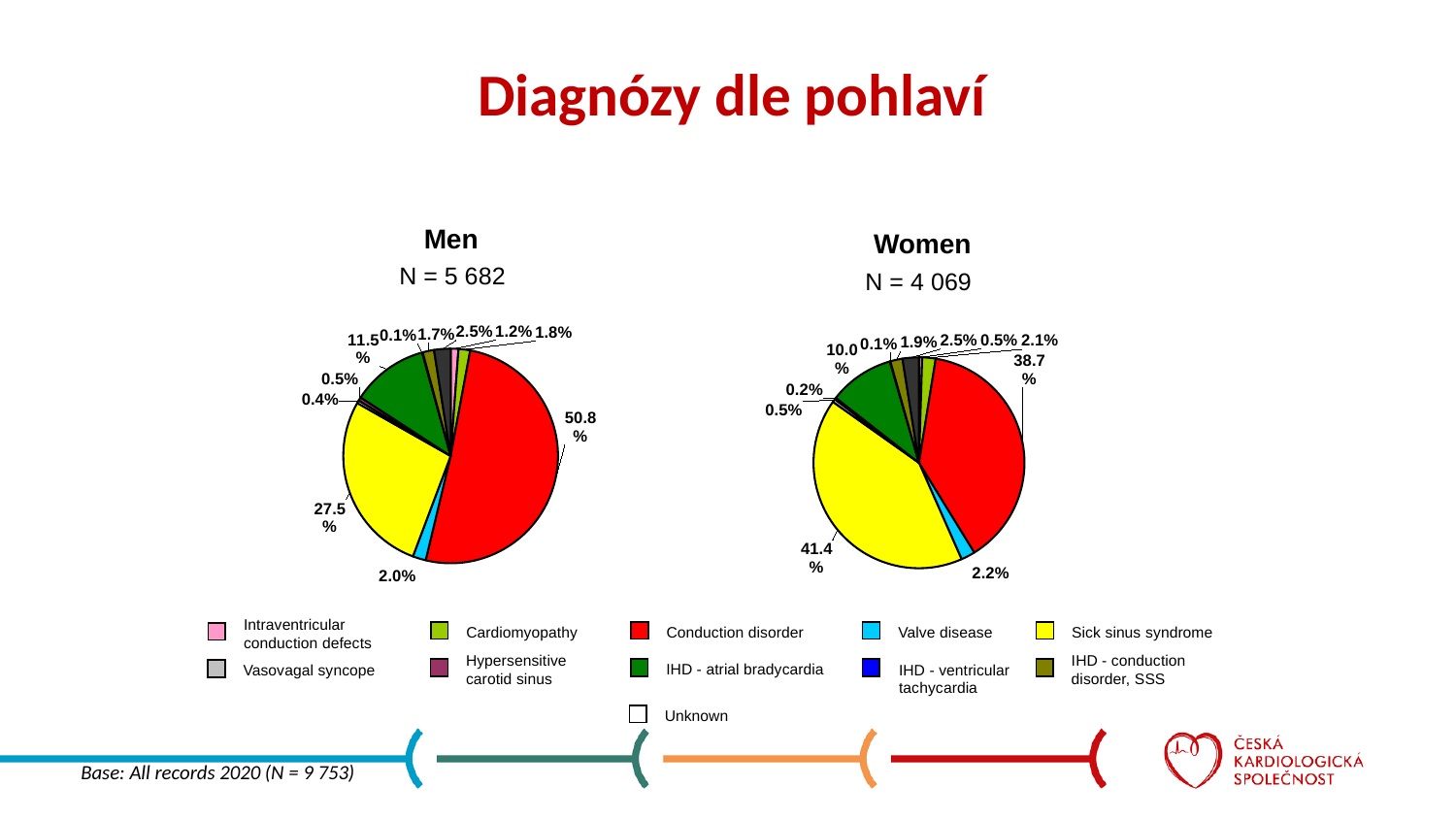
In the Women pie chart, what share is shown for Valve disease? 2.2% What type of chart is used for the Men and Women diagnoses? Pie chart In the Women pie chart, what share is shown for Sick sinus syndrome? 41.4% In the Women pie chart, which diagnosis has the largest slice? Sick sinus syndrome In the Men pie chart, what share is shown for Valve disease? 2.0% What is the N value shown for the Women pie chart? N = 4 069 In the Men pie chart, what is the difference in percentage points between Conduction disorder and Sick sinus syndrome? 23.3 percentage points In the Women pie chart, which is larger: Conduction disorder or Sick sinus syndrome? Sick sinus syndrome In the Men pie chart, what share is shown for IHD - atrial bradycardia? 11.5% In the Men pie chart, what share is shown for Conduction disorder? 50.8% How many diagnosis categories does the legend list? 11 In the Men pie chart, which diagnosis has the largest slice? Conduction disorder